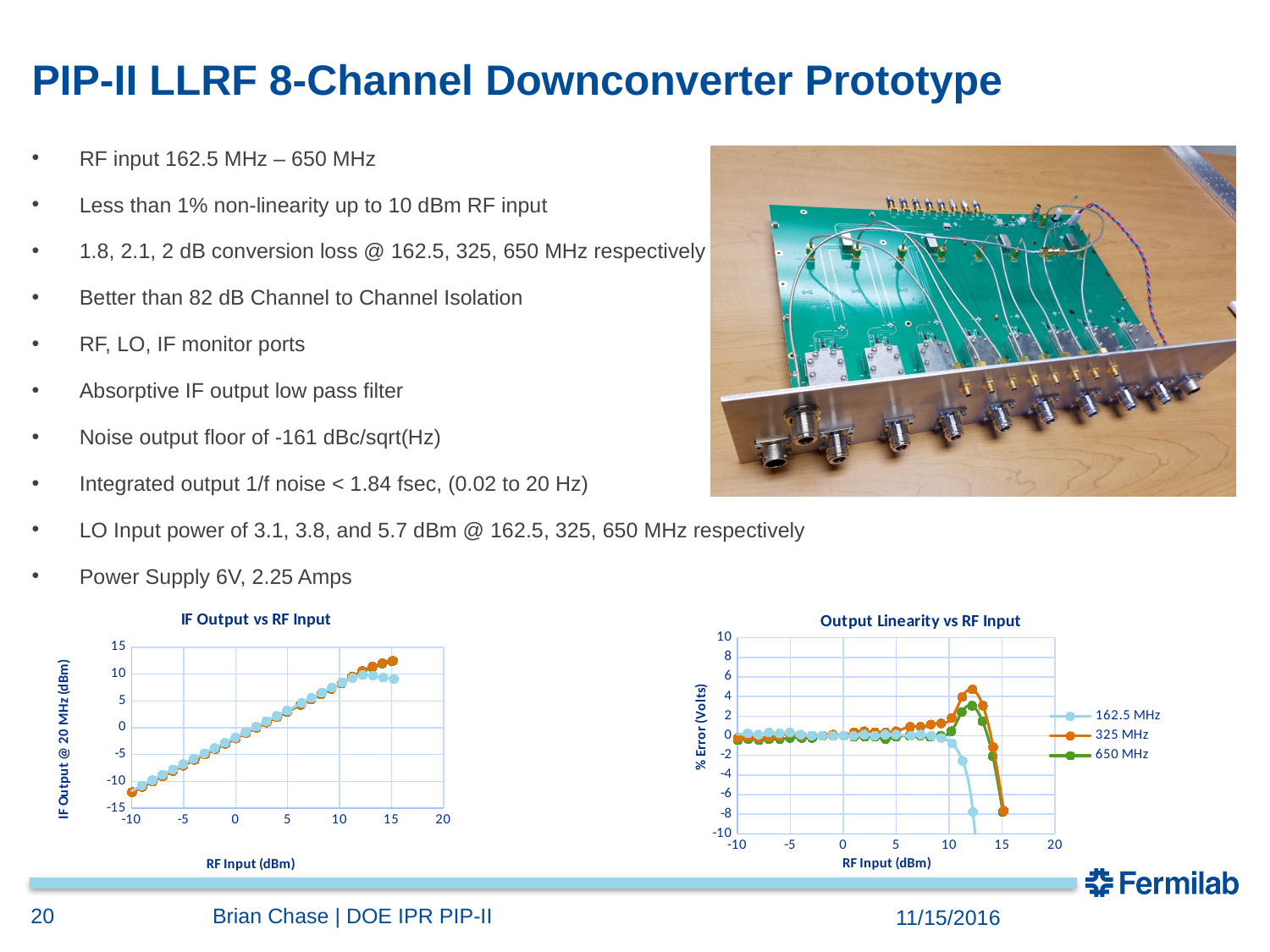
In the 'Output Linearity vs RF Input' chart, is the peak % error of the 650 MHz series greater or less than 2? greater In the 'IF Output vs RF Input' chart, is the IF output at an RF input of -10 dBm greater or less than -10? less What are the legend entries of the 'Output Linearity vs RF Input' chart? 162.5 MHz, 325 MHz, 650 MHz How many series does the legend of the 'Output Linearity vs RF Input' chart list? 3 What kind of chart is the 'IF Output vs RF Input' chart? line chart What is the y-axis label of the 'IF Output vs RF Input' chart? IF Output @ 20 MHz (dBm) In the 'Output Linearity vs RF Input' chart, is the peak % error of the 325 MHz series greater or less than 4? greater In the 'Output Linearity vs RF Input' chart, which series has the larger % error at an RF input of 12 dBm, 162.5 MHz or 325 MHz? 325 MHz In the 'IF Output vs RF Input' chart, does the IF output rise or fall as RF input increases from -10 to 10 dBm? rise What kind of chart is the 'Output Linearity vs RF Input' chart? line chart In the 'Output Linearity vs RF Input' chart, which series reaches the highest % error? 325 MHz In the 'Output Linearity vs RF Input' chart, does the % error of the 162.5 MHz series rise or fall as RF input increases from 10 to 12 dBm? fall